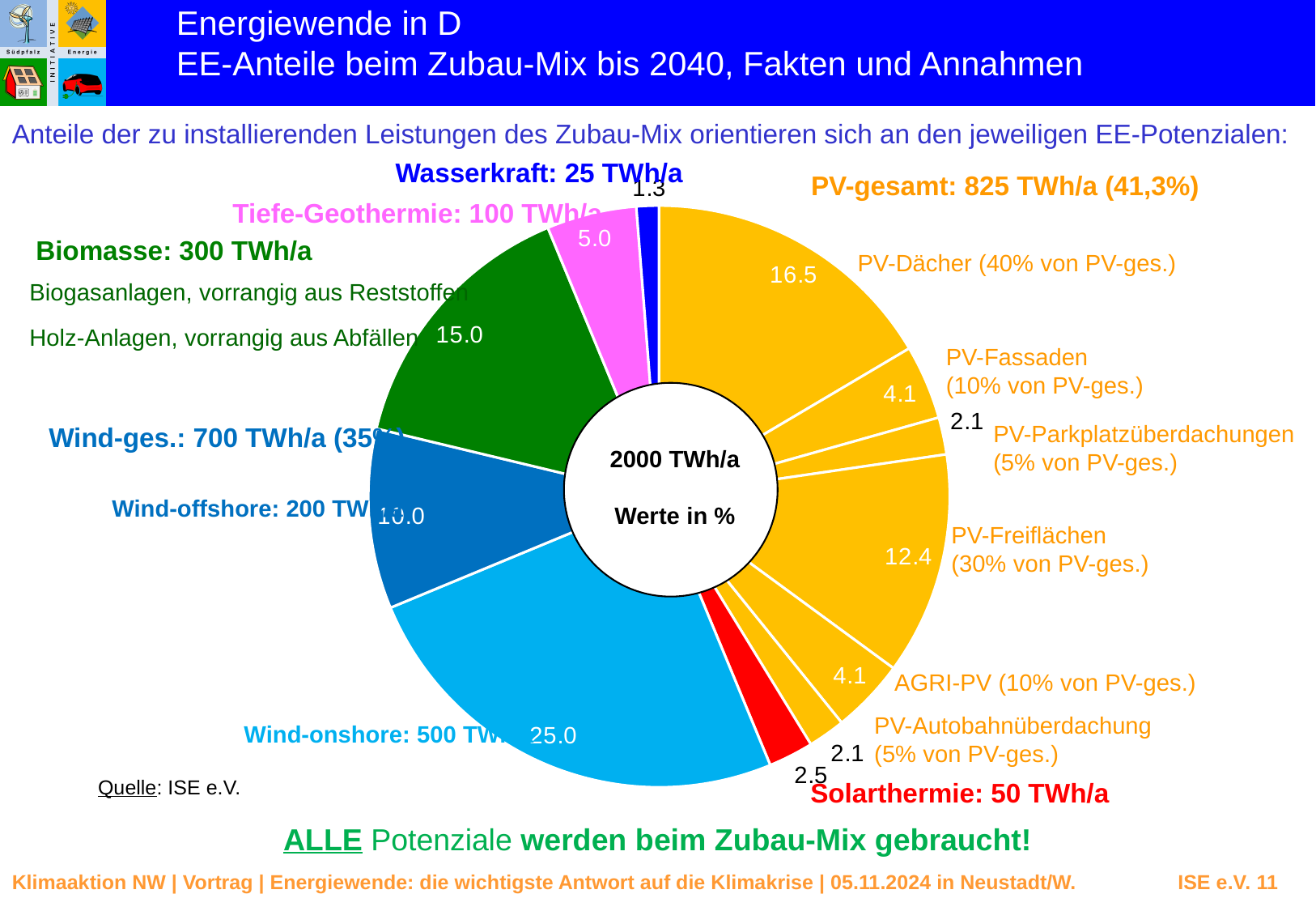
What percentage value is shown for the Wind-onshore slice? 25.0 What total is written in the centre of the pie chart? 2000 TWh/a How many slices does the pie chart have? 12 Which is larger, the Biomasse slice or the PV-Freiflächen slice? Biomasse Which slice of the pie chart has the largest value? Wind-onshore What is the difference between the Wind-onshore value and the Wind-offshore value? 15.0 What percentage value is shown for the PV-Dächer slice? 16.5 Which slice of the pie chart has the smallest value? Wasserkraft What percentage value is shown for the PV-Freiflächen slice? 12.4 What percentage value is shown for the Biomasse slice? 15.0 What percentage value is shown for the Wasserkraft slice? 1.3 What type of chart is shown on the slide? pie chart